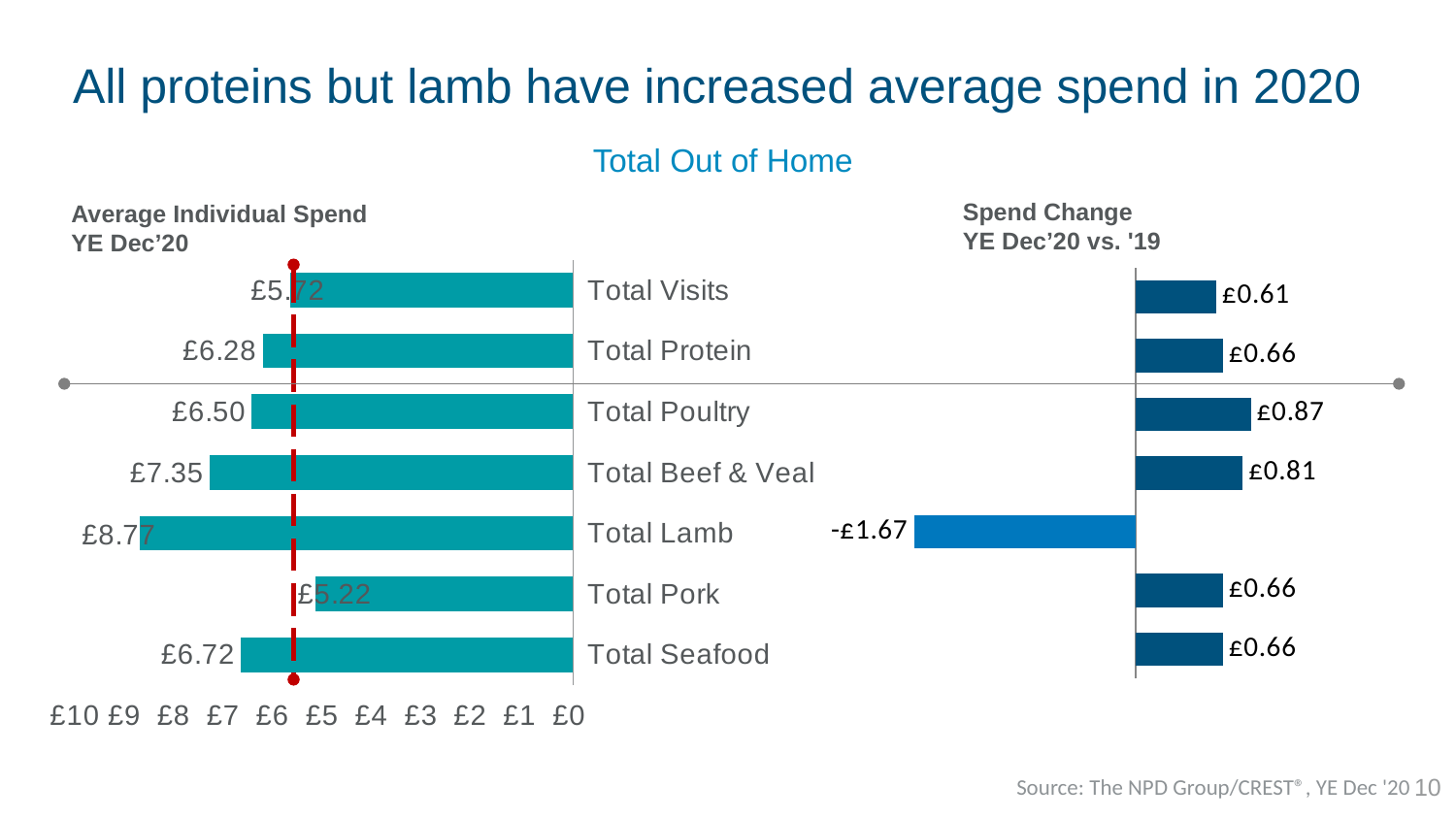
In the Spend Change YE Dec'20 vs. '19 chart, which category has the highest value? Total Poultry In the Average Individual Spend YE Dec'20 chart, what is the value for Total Beef & Veal? £7.35 In the Average Individual Spend YE Dec'20 chart, what is the value for Total Lamb? £8.77 In the Average Individual Spend YE Dec'20 chart, which category has the highest value? Total Lamb In the Spend Change YE Dec'20 vs. '19 chart, what is the value for Total Poultry? £0.87 In the Spend Change YE Dec'20 vs. '19 chart, which category has the lowest value? Total Lamb How many categories are shown in the Average Individual Spend YE Dec'20 chart? 7 In the Average Individual Spend YE Dec'20 chart, what is the difference between Total Lamb and Total Pork? £3.55 What kind of chart is the Spend Change YE Dec'20 vs. '19 chart? Bar chart In the Average Individual Spend YE Dec'20 chart, which category has the lowest value? Total Pork In the Spend Change YE Dec'20 vs. '19 chart, what is the value for Total Lamb? -£1.67 In the Spend Change YE Dec'20 vs. '19 chart, which is larger, Total Poultry or Total Beef & Veal? Total Poultry